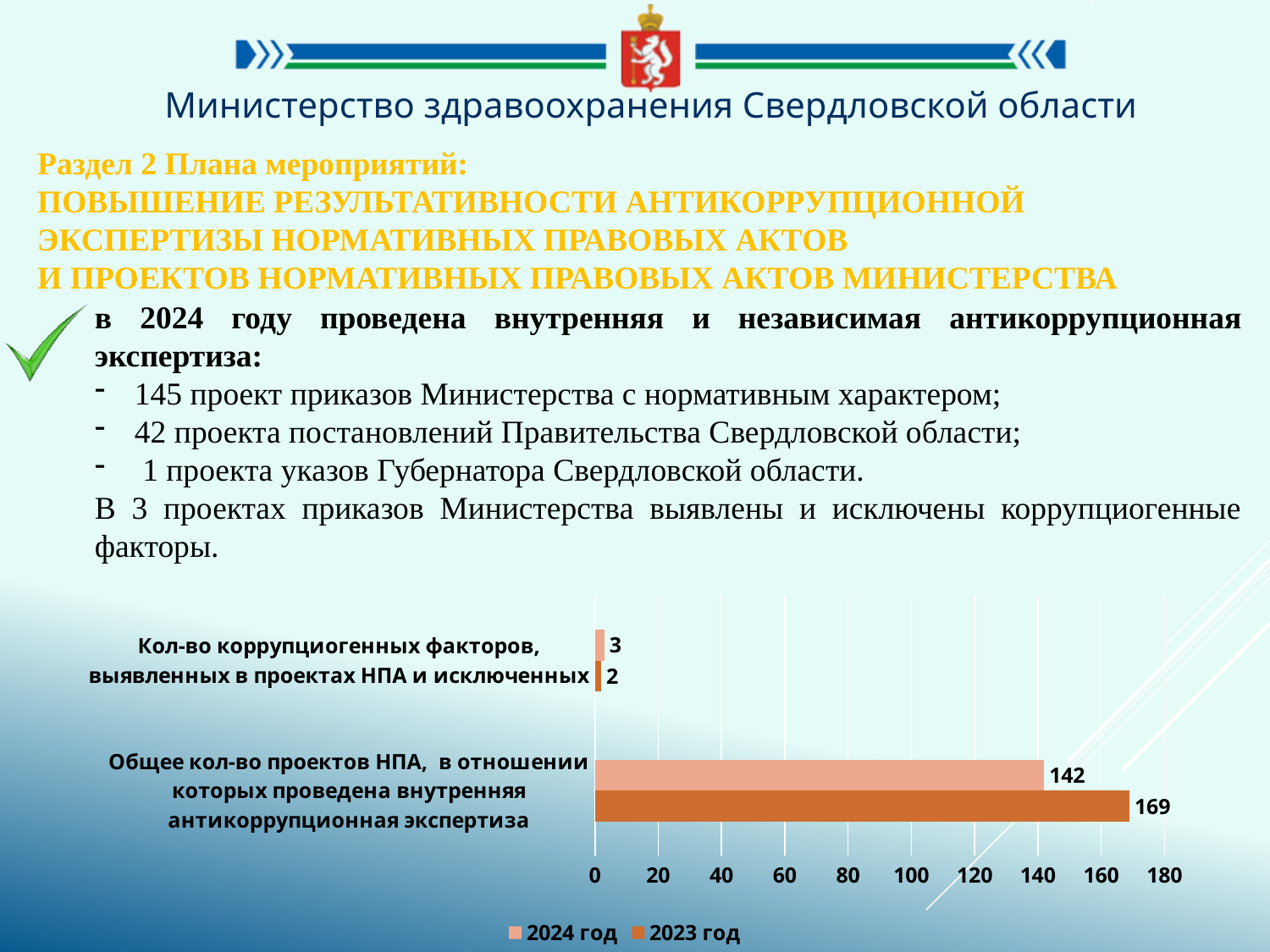
What is the difference between the 2023 год and 2024 год values for 'Общее кол-во проектов НПА, в отношении которых проведена внутренняя антикоррупционная экспертиза'? 27 What is the value for 2023 год for 'Кол-во коррупциогенных факторов, выявленных в проектах НПА и исключенных'? 2 Which series has the larger value for 'Кол-во коррупциогенных факторов, выявленных в проектах НПА и исключенных': 2024 год or 2023 год? 2024 год What kind of chart is shown on the slide? bar chart What is the value for 2023 год for 'Общее кол-во проектов НПА, в отношении которых проведена внутренняя антикоррупционная экспертиза'? 169 What is the highest value shown on the chart's horizontal axis? 180 What is the value for 2024 год for 'Кол-во коррупциогенных факторов, выявленных в проектах НПА и исключенных'? 3 How many series does the chart legend list? 2 What is the value for 2024 год for 'Общее кол-во проектов НПА, в отношении которых проведена внутренняя антикоррупционная экспертиза'? 142 How many categories are shown on the chart? 2 Which series has the larger value for 'Общее кол-во проектов НПА, в отношении которых проведена внутренняя антикоррупционная экспертиза': 2024 год or 2023 год? 2023 год Is the 2023 год value for 'Общее кол-во проектов НПА, в отношении которых проведена внутренняя антикоррупционная экспертиза' greater or less than 160? greater